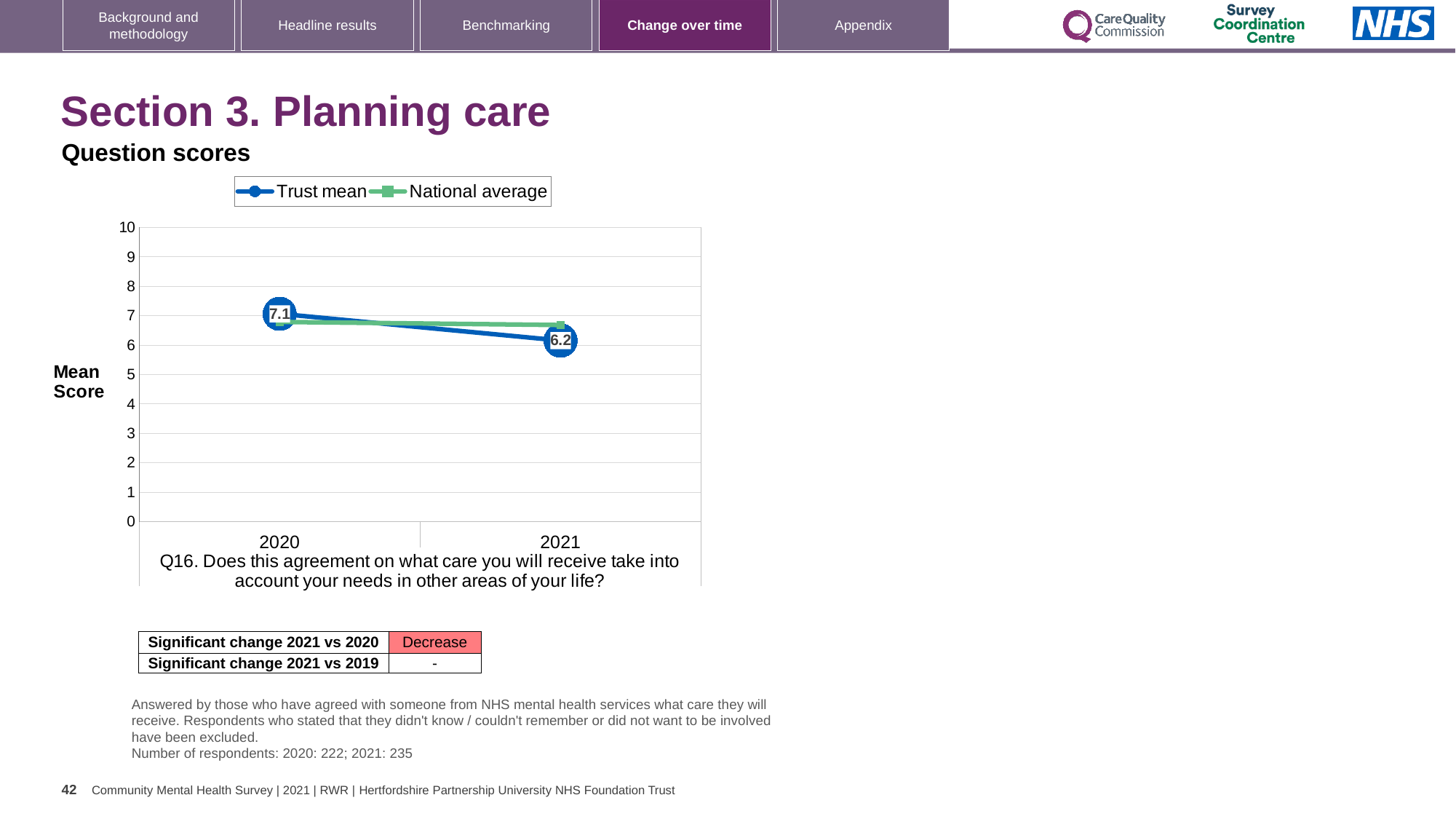
Is the National average for 2021 greater or less than 6? greater By how much did the Trust mean score change from 2020 to 2021? 0.9 What kind of chart is shown on the slide? line chart What is the Trust mean score for 2020? 7.1 How many series does the legend list? 2 How many years are plotted on the x axis? 2 Is the National average for 2020 greater or less than 7? less What is the Trust mean score for 2021? 6.2 In 2021, which is higher: the Trust mean or the National average? National average Does the Trust mean rise or fall from 2020 to 2021? fall In which year is the Trust mean score highest? 2020 In which year is the Trust mean score lowest? 2021